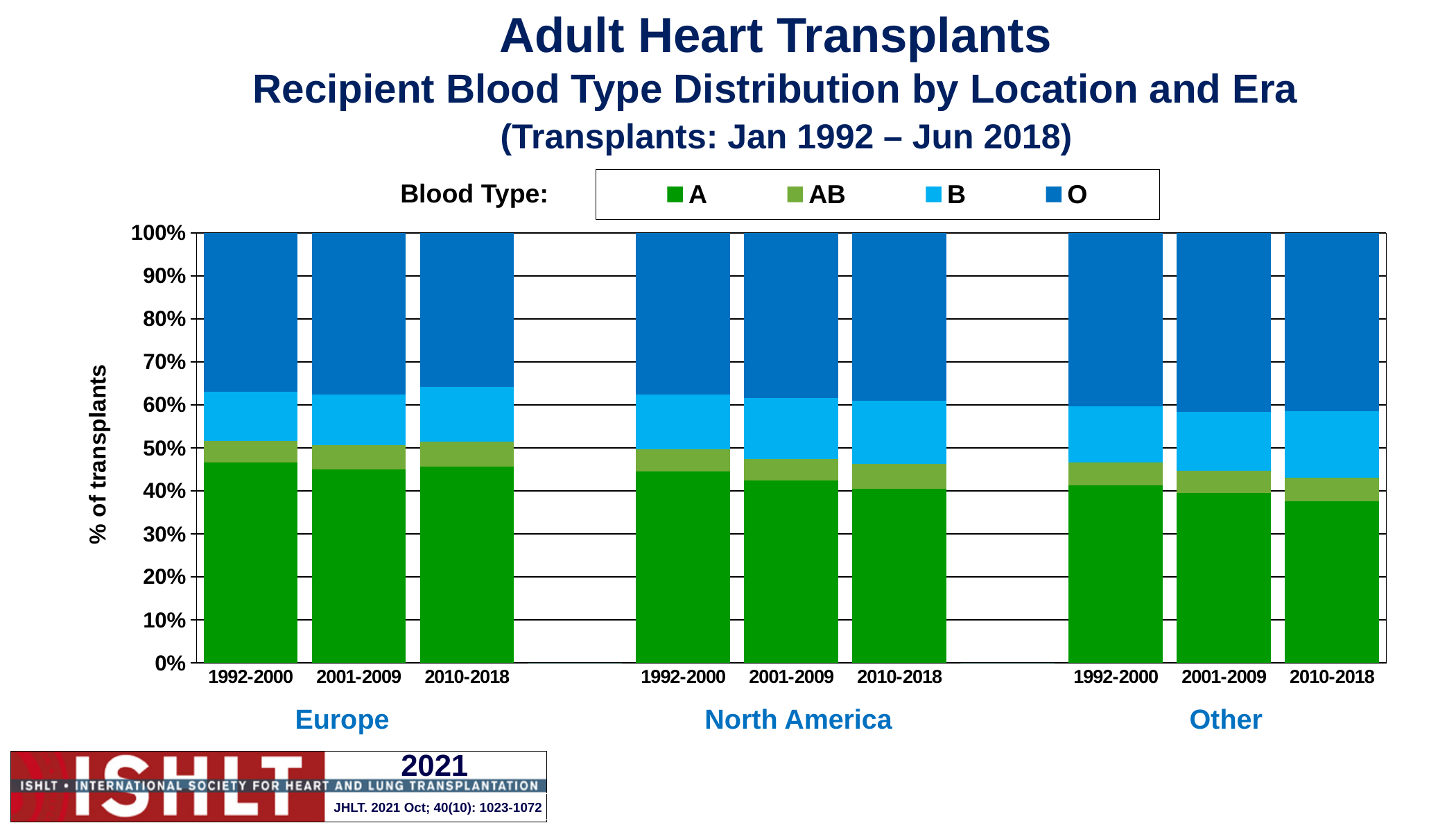
Is the share of blood type A recipients in Europe for 1992-2000 greater or less than 40%? greater How many blood types does the legend list? 4 How many bars are plotted in the chart? 9 Which has the larger share of blood type A recipients: Europe 1992-2000 or Other 2010-2018? Europe 1992-2000 Which bar has the smallest share of blood type A recipients? Other 2010-2018 In North America, does the share of blood type A recipients rise or fall from 1992-2000 to 2010-2018? fall Which three locations are shown along the x axis? Europe, North America, Other What kind of chart is shown on the slide? Stacked bar chart Is the share of blood type O recipients in Other for 2010-2018 greater or less than 30%? greater How many eras are shown for each location? 3 What is the label on the y axis? % of transplants Is the share of blood type A recipients in Other for 2010-2018 greater or less than 40%? less